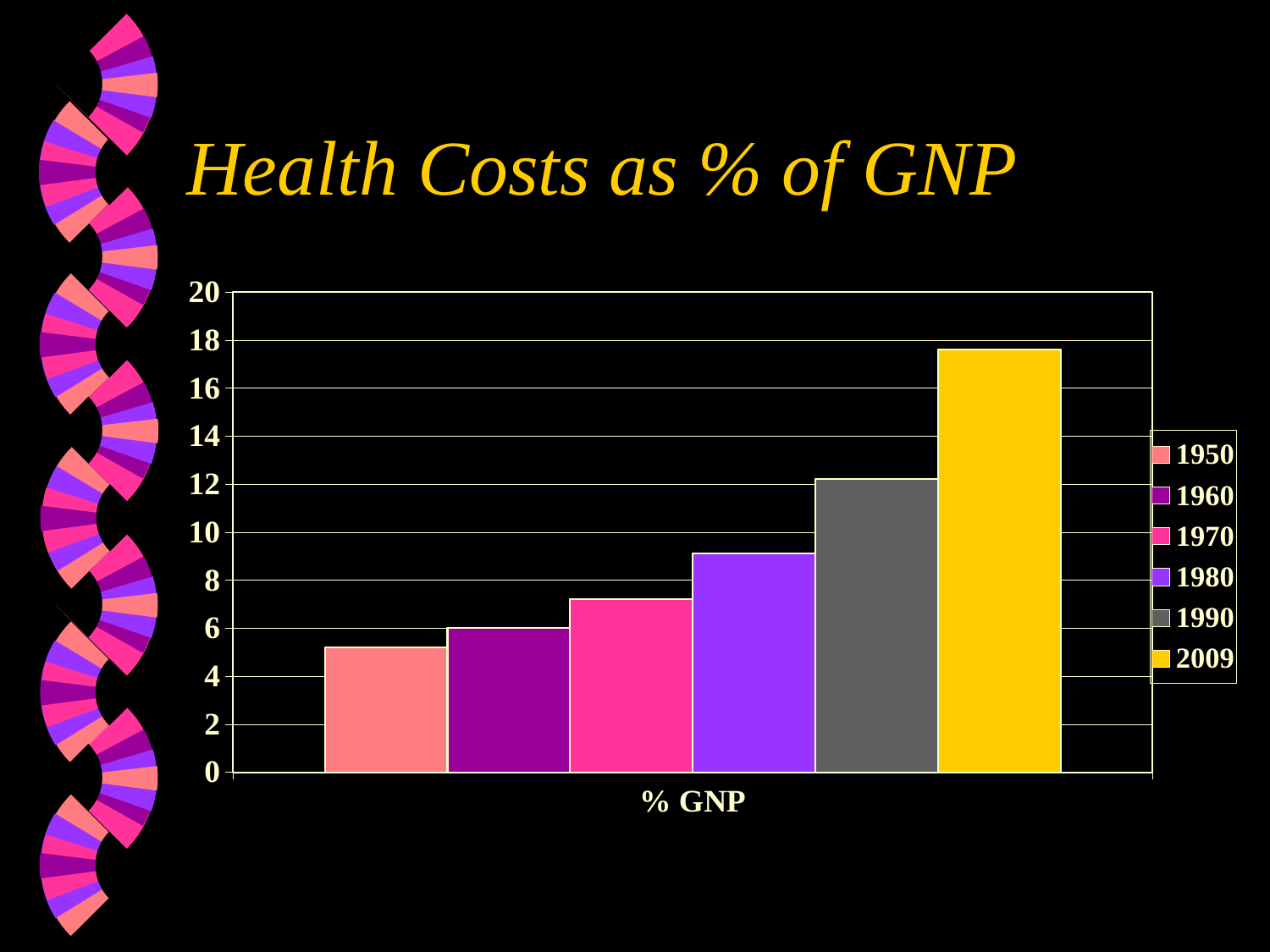
Is the value for 1980 greater or less than 8? greater Do the values rise or fall from 1950 to 2009? rise Which is larger, the value for 1980 or the value for 1990? 1990 What type of chart is shown on the slide? bar chart Which year has the lowest health costs as % of GNP? 1950 How many series does the legend list? 6 Is the value for 1990 greater or less than 10? greater What is the title of the chart? Health Costs as % of GNP Is the value for 2009 greater or less than 16? greater Which year has the highest health costs as % of GNP? 2009